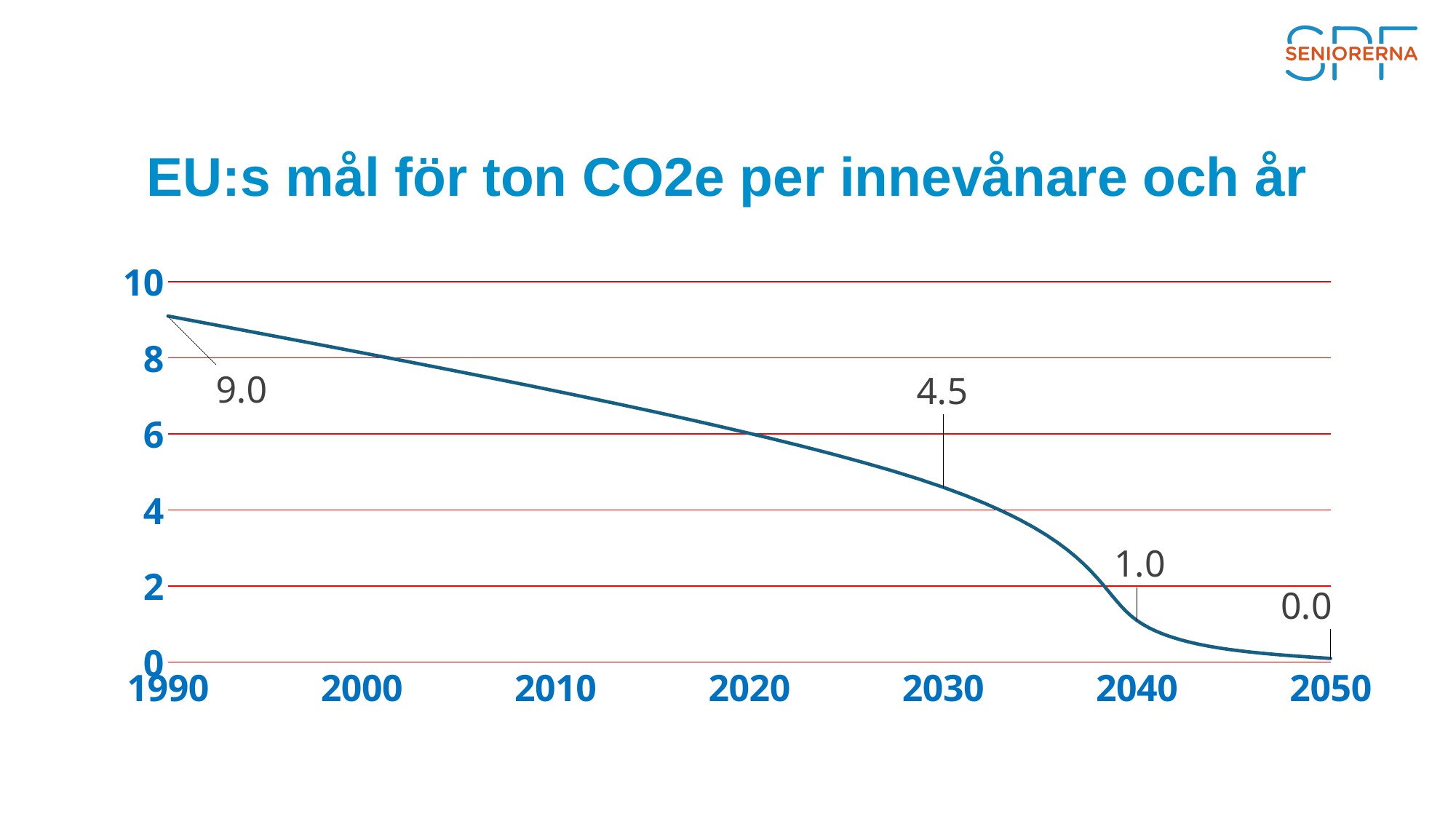
What is the difference between the values for 1990 and 2030? 4.5 What kind of chart is shown on the slide? line chart Which year has the lowest value on the line? 2050 Which is larger, the value for 2030 or the value for 2040? 2030 What is the difference between the values for 2030 and 2040? 3.5 Is the value for 2010 greater or less than 6? greater Which year has the highest value on the line? 1990 What is the value for 2030? 4.5 What is the value for 2050? 0.0 Do the values rise or fall from 1990 to 2050? fall What is the value for 1990? 9.0 What is the value for 2040? 1.0